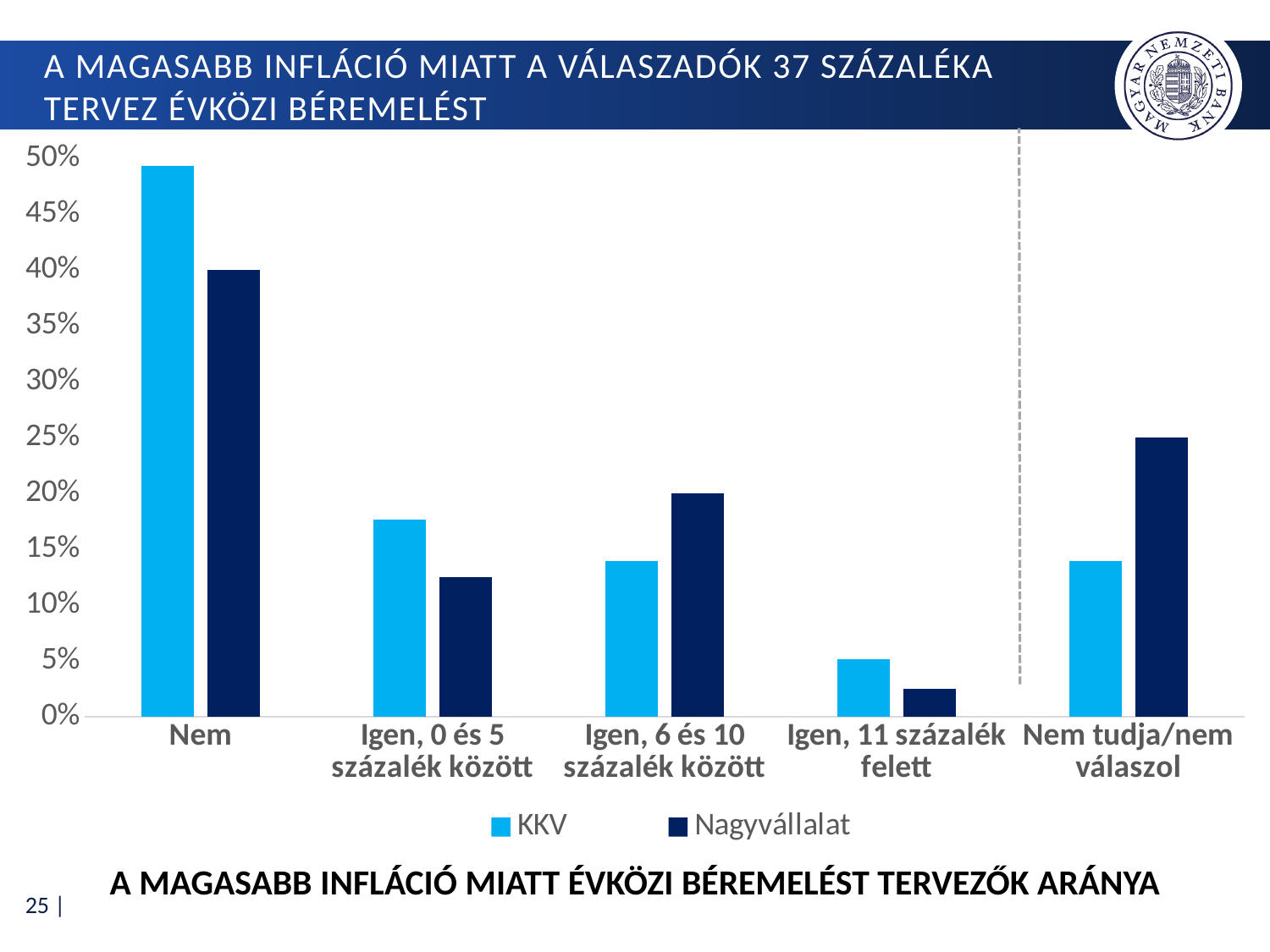
Is the KKV value for Nem greater or less than 45%? greater Which category has the highest value for the KKV series? Nem Is the Nagyvállalat value for Nem tudja/nem válaszol greater or less than 20%? greater How many categories are shown on the x axis? 5 What are the two series names listed in the legend? KKV and Nagyvállalat For the category Nem, which series has the larger value, KKV or Nagyvállalat? KKV For the category Nem tudja/nem válaszol, which series has the larger value, KKV or Nagyvállalat? Nagyvállalat What kind of chart is shown on the slide? bar chart Which category has the lowest value for the Nagyvállalat series? Igen, 11 százalék felett Is the Nagyvállalat value for Nem greater or less than 45%? less How many series does the legend list? 2